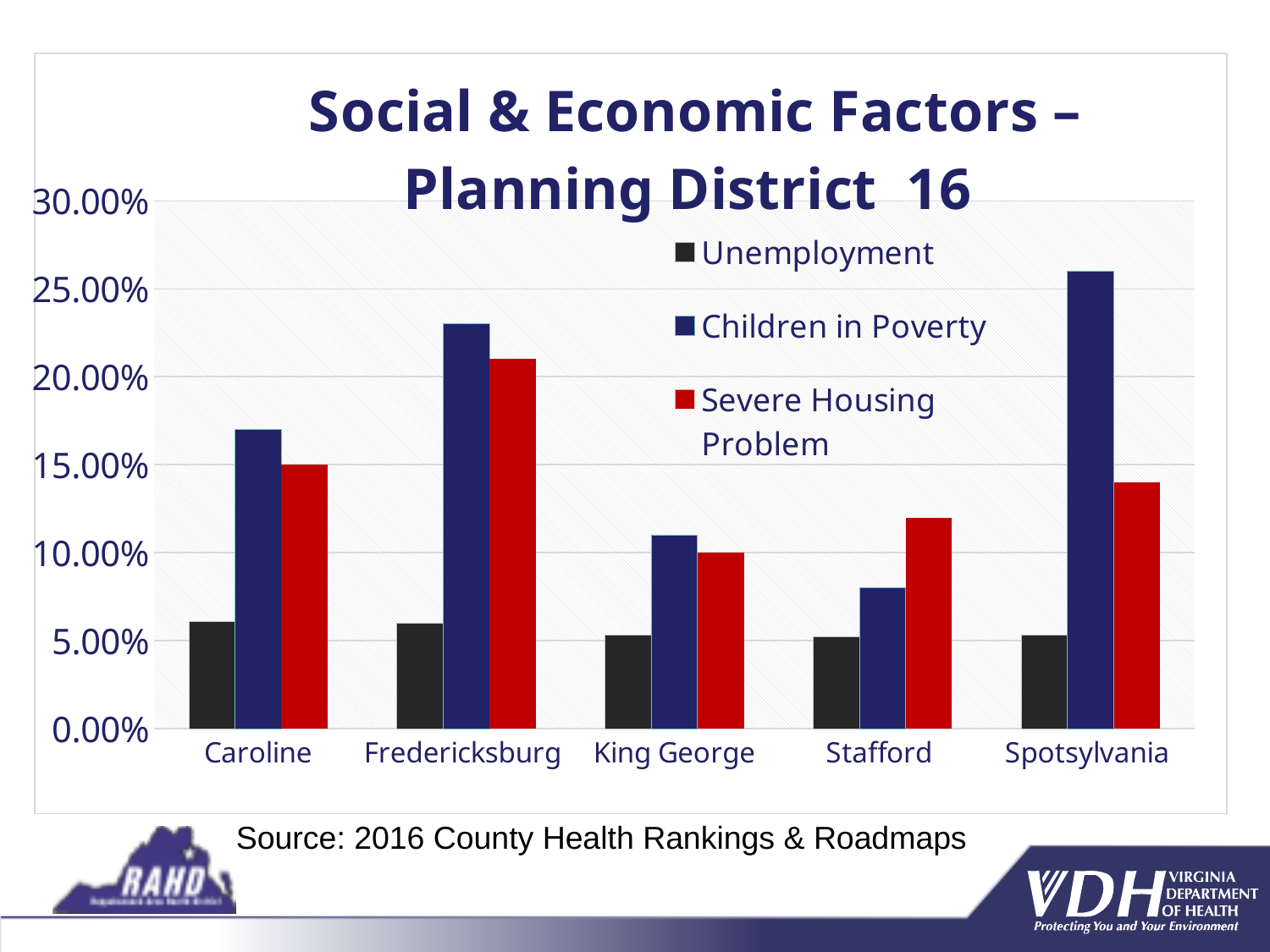
How many localities are shown on the x axis? 5 What kind of chart is shown on the slide? bar chart Is the Children in Poverty value for Fredericksburg greater or less than 20.00%? greater Which is larger for Caroline, Children in Poverty or Severe Housing Problem? Children in Poverty What is the title of the chart? Social & Economic Factors – Planning District 16 Which locality has the lowest Children in Poverty value? Stafford Which is larger for Stafford, Children in Poverty or Severe Housing Problem? Severe Housing Problem How many series does the legend list? 3 Is the Unemployment value for Caroline greater or less than 10.00%? less Which locality has the highest Severe Housing Problem value? Fredericksburg Which locality has the highest Children in Poverty value? Spotsylvania Is the Children in Poverty value for Spotsylvania greater or less than 25.00%? greater